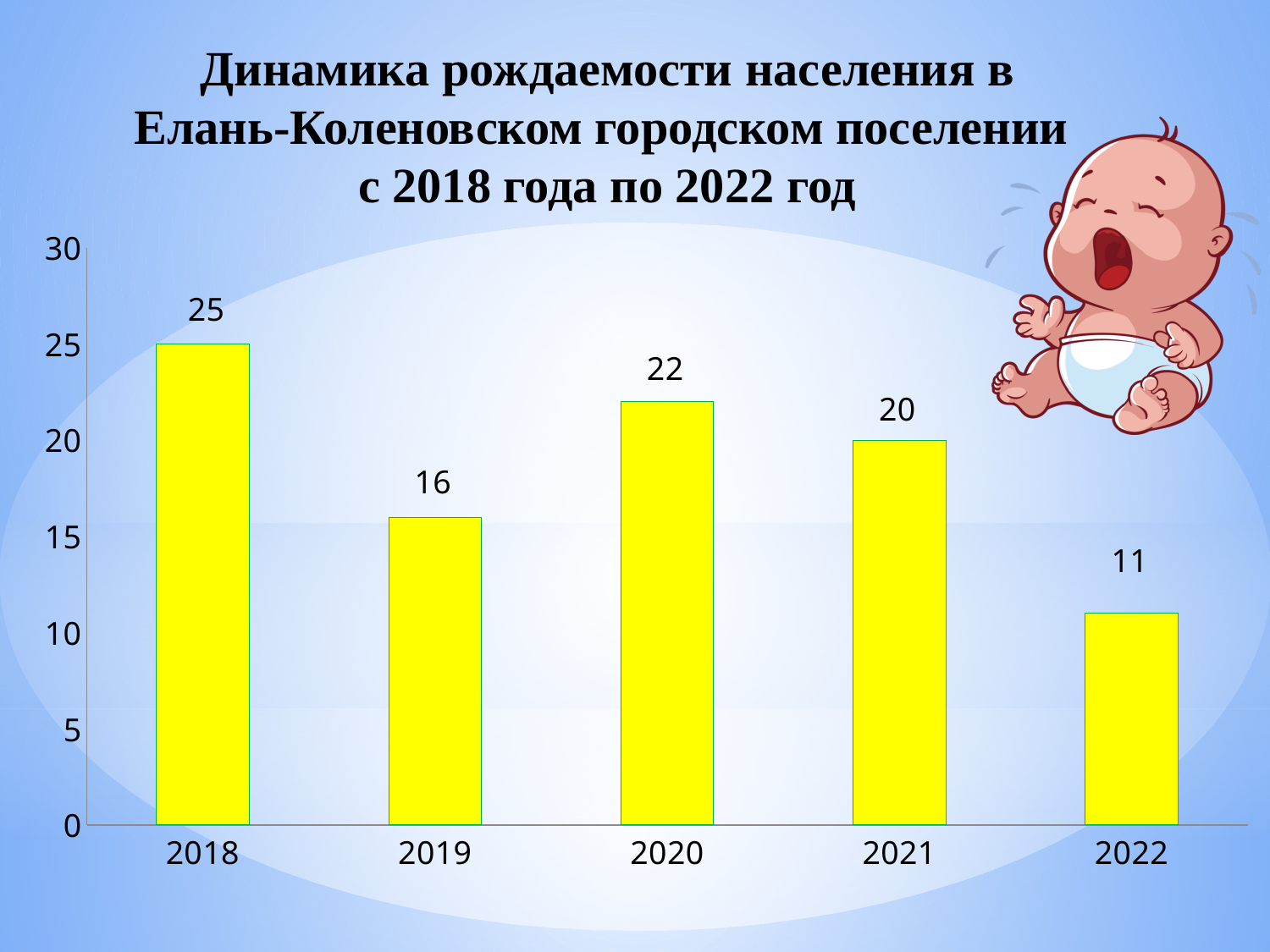
What kind of chart is shown on the slide? bar chart What colour are the bars in the chart? yellow Which year has the highest value? 2018 Which is larger, the value for 2019 or the value for 2021? 2021 What is the value for 2022? 11 What is the difference between the values for 2020 and 2021? 2 What is the value for 2018? 25 What is the difference between the values for 2018 and 2022? 14 Is the value for 2020 greater or less than 20? greater How many years are shown on the chart? 5 What is the value for 2019? 16 Which year has the lowest value? 2022